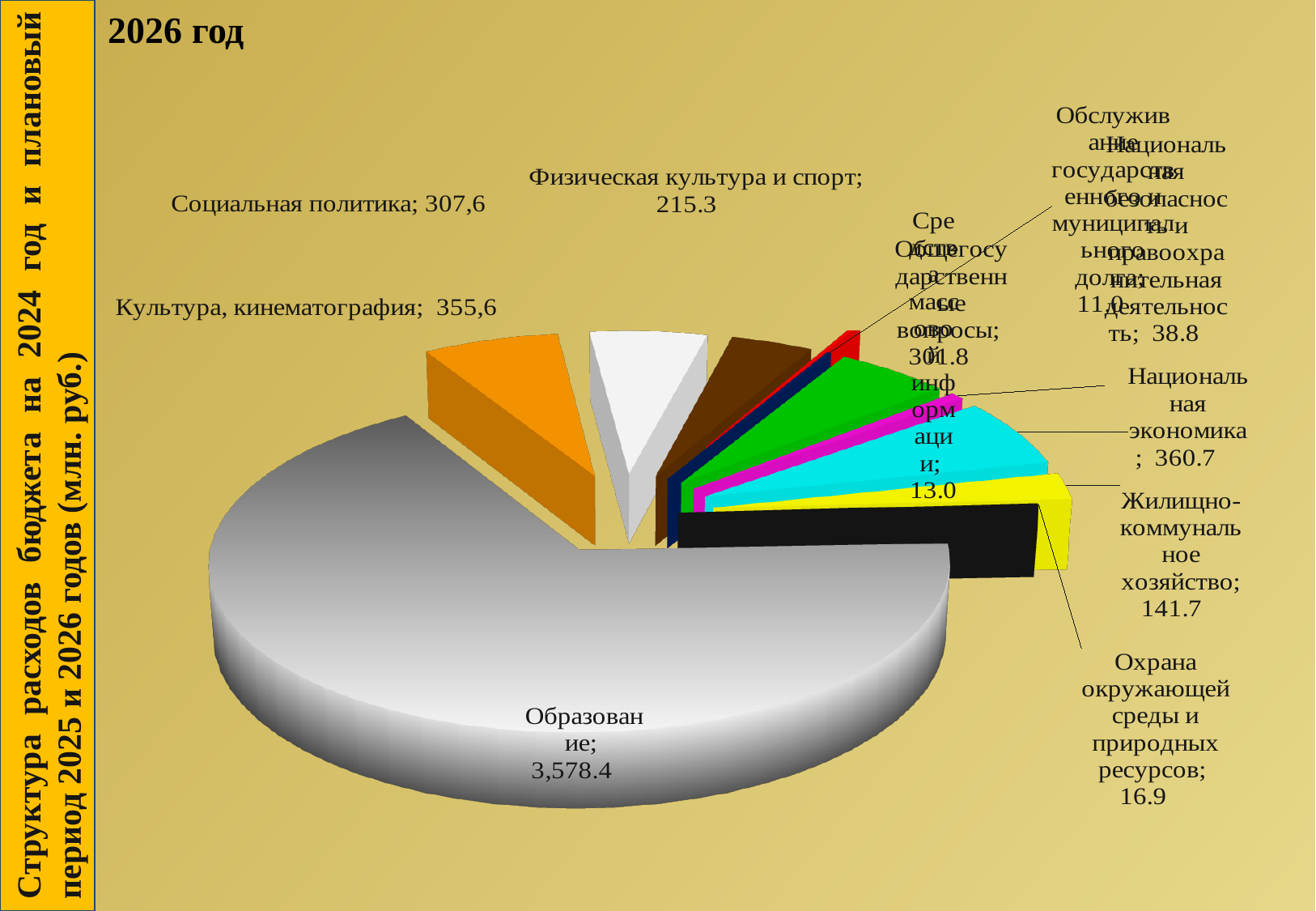
What is the value for Охрана окружающей среды и природных ресурсов? 16.9 What is the value for Жилищно-коммунальное хозяйство? 141.7 Which category has the largest slice of the pie? Образование What is the value for Образование? 3,578.4 What is the value for Социальная политика? 307,6 What is the difference between Жилищно-коммунальное хозяйство and Охрана окружающей среды и природных ресурсов? 124.8 Which is larger: Социальная политика or Физическая культура и спорт? Социальная политика Which year does the chart title refer to? 2026 год What is the difference between Национальная безопасность и правоохранительная деятельность and Охрана окружающей среды и природных ресурсов? 21.9 What is the value for Национальная экономика? 360.7 What type of chart is shown on the slide? Pie chart Which is larger: Национальная безопасность и правоохранительная деятельность or Охрана окружающей среды и природных ресурсов? Национальная безопасность и правоохранительная деятельность